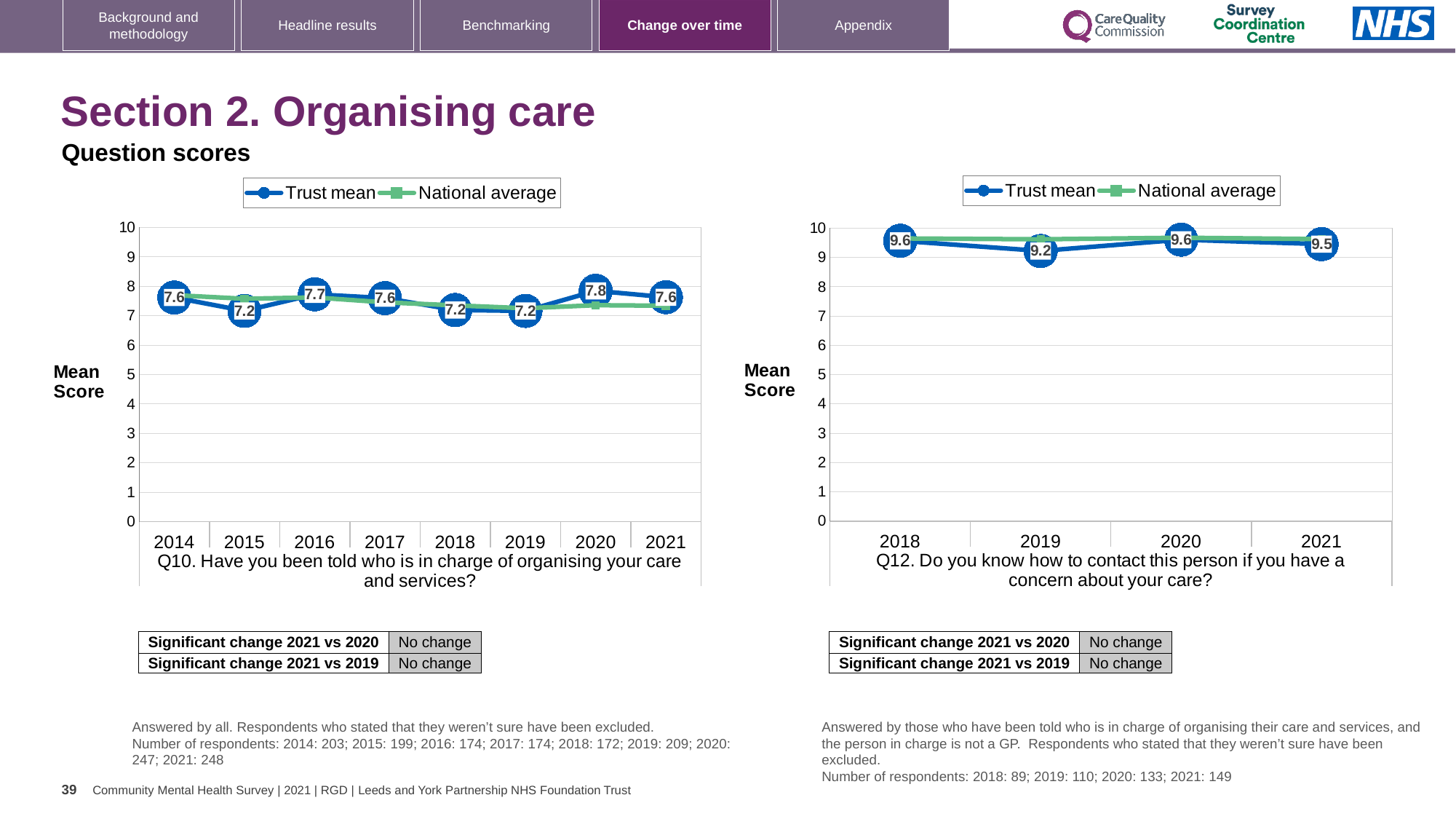
In the Q12 chart on the right, what is the Trust mean score for 2021? 9.5 In the Q12 chart on the right, which year has the lowest Trust mean score? 2019 In the Q10 chart on the left, what is the Trust mean score for 2014? 7.6 In the Q10 chart on the left, what is the Trust mean score for 2020? 7.8 In the Q10 chart on the left, is the Trust mean score higher in 2016 or in 2015? 2016 In the Q12 chart on the right, is the National average value for 2019 greater or less than 9? greater How many years are shown on the x axis of the Q10 chart on the left? 8 In the Q10 chart on the left, what is the difference between the Trust mean scores for 2020 and 2021? 0.2 In the Q12 chart on the right, what is the Trust mean score for 2019? 9.2 In the Q12 chart on the right, what is the difference between the Trust mean scores for 2018 and 2019? 0.4 In the Q10 chart on the left, which year has the highest Trust mean score? 2020 How many series does the legend of the Q12 chart on the right list? 2